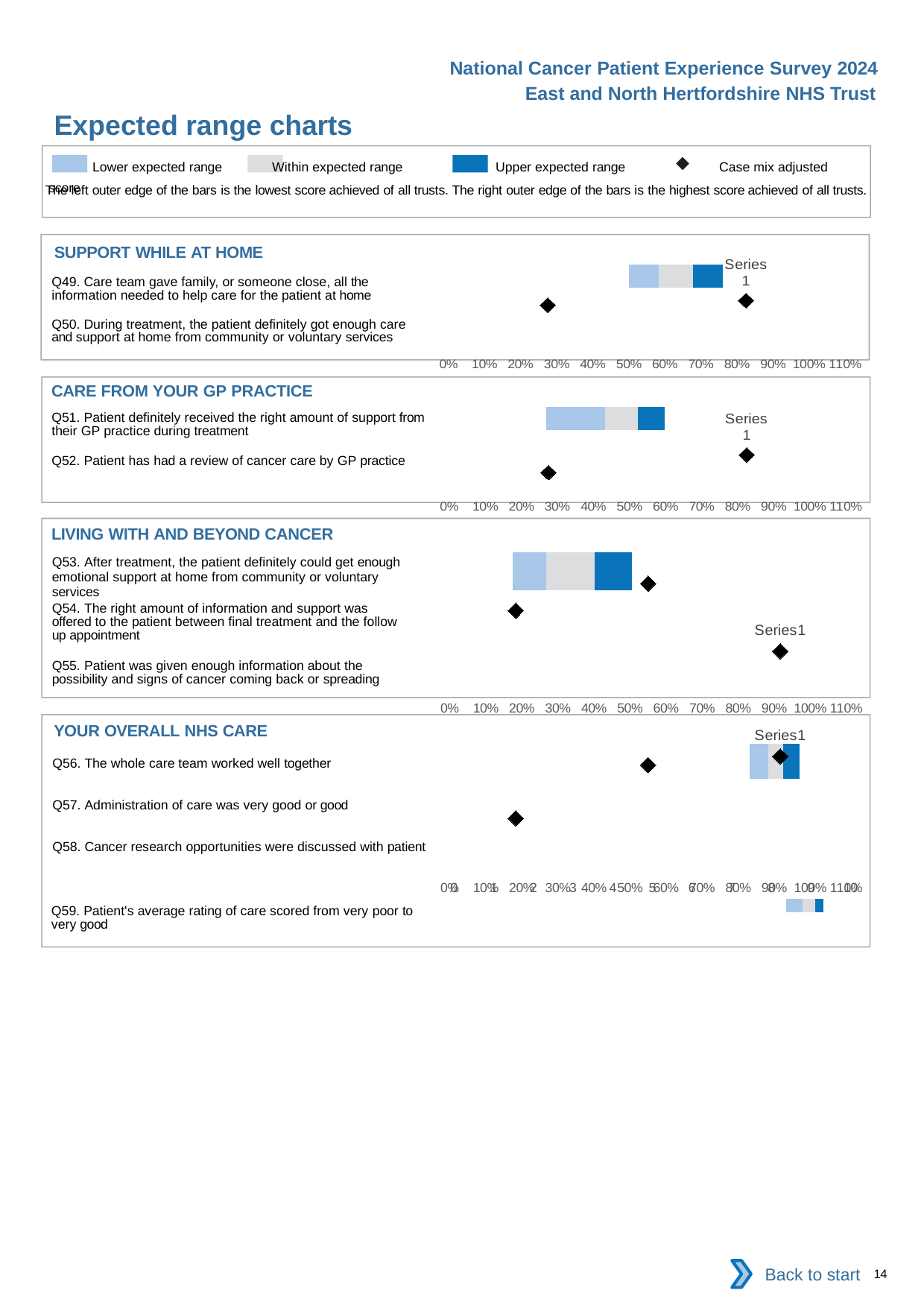
How many entries does the legend at the top of the slide list? 4 In the 'SUPPORT WHILE AT HOME' chart, is the rightmost diamond marker greater or less than 70%? greater In the 'LIVING WITH AND BEYOND CANCER' chart, is the leftmost diamond marker greater or less than 30%? less In the 'CARE FROM YOUR GP PRACTICE' chart, is the leftmost diamond marker greater or less than 40%? less Which legend entry is represented by a diamond marker? Case mix adjusted score What kind of chart is used in the 'SUPPORT WHILE AT HOME' section? Bar chart How many questions are listed in the 'YOUR OVERALL NHS CARE' section? 4 How many questions are listed in the 'CARE FROM YOUR GP PRACTICE' section? 2 How many questions are listed in the 'LIVING WITH AND BEYOND CANCER' section? 3 What is the highest axis tick shown on the 'SUPPORT WHILE AT HOME' chart? 110%